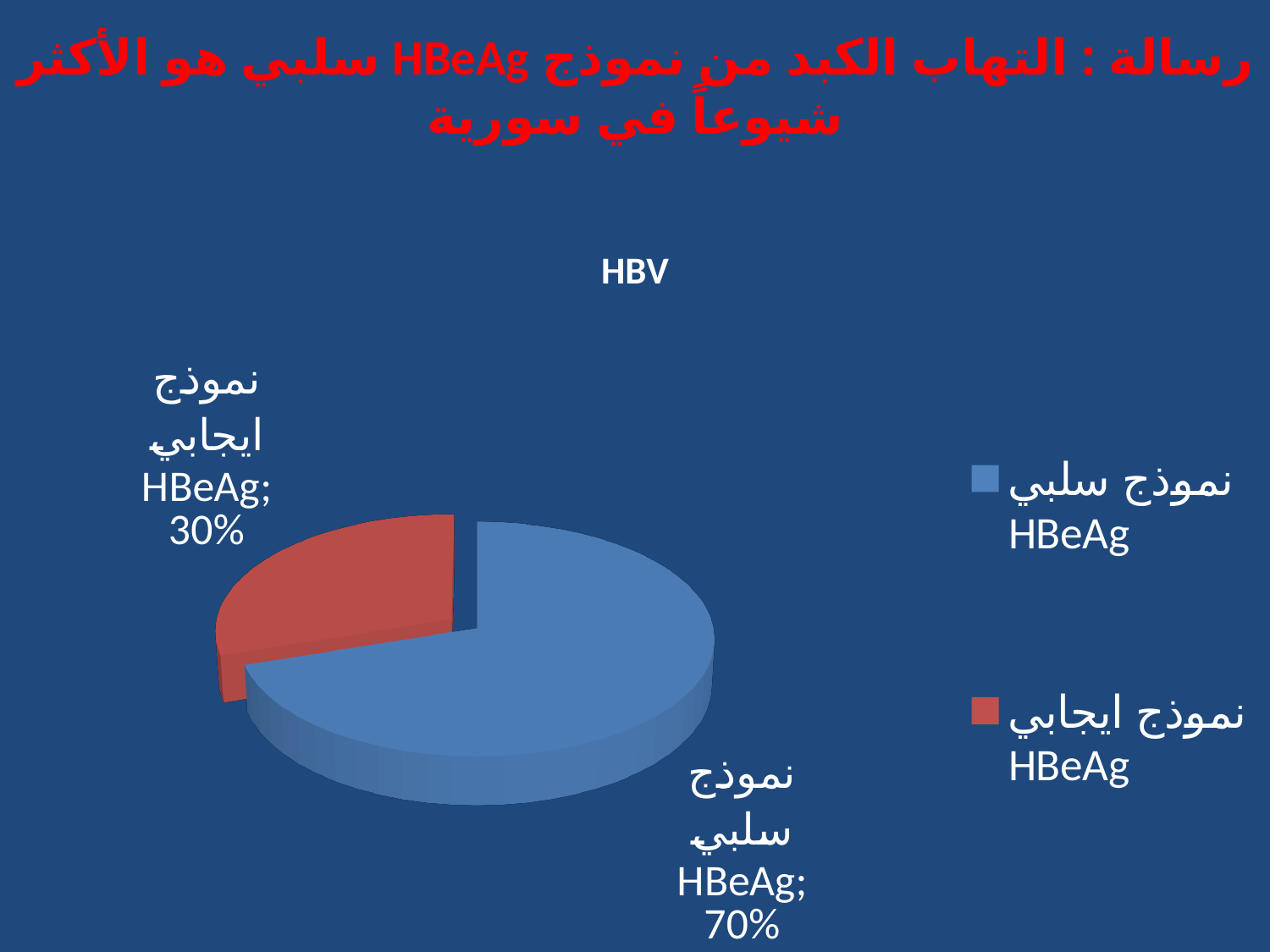
Which slice of the pie is the smallest? نموذج ايجابي HBeAg What is the title of the chart? HBV What percentage is shown for the HBeAg negative pattern (نموذج سلبي HBeAg)? 70% What kind of chart is shown on the slide? pie chart Which is larger, the HBeAg negative slice or the HBeAg positive slice? نموذج سلبي HBeAg Which slice of the pie is the largest? نموذج سلبي HBeAg What colour is the slice for نموذج ايجابي HBeAg? red What share of the pie does the HBeAg negative pattern take? 70% What percentage is shown for the HBeAg positive pattern (نموذج ايجابي HBeAg)? 30% How many entries does the legend list? 2 What is the difference in percentage points between the HBeAg negative and HBeAg positive slices? 40 How many slices does the pie chart have? 2